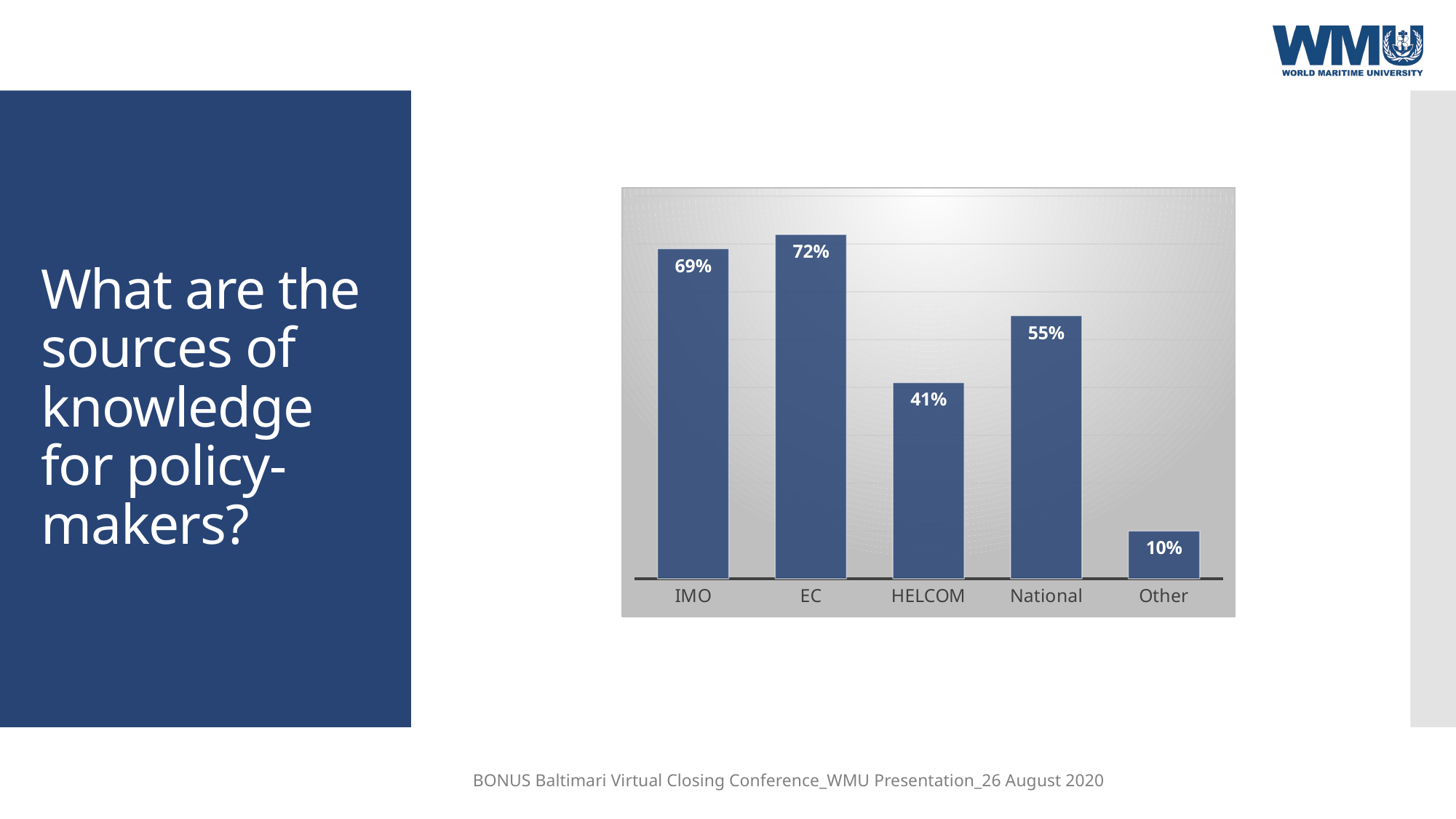
What is the value for IMO? 69% What is the difference between the values for IMO and Other? 59% What kind of chart is shown on the slide? Bar chart Which category has the lowest value? Other Which category has the highest value? EC Which is larger, the value for National or the value for HELCOM? National What is the value for Other? 10% How many categories are shown on the chart? 5 What is the value for HELCOM? 41% What is the difference between the values for EC and HELCOM? 31% What is the value for National? 55% What is the value for EC? 72%